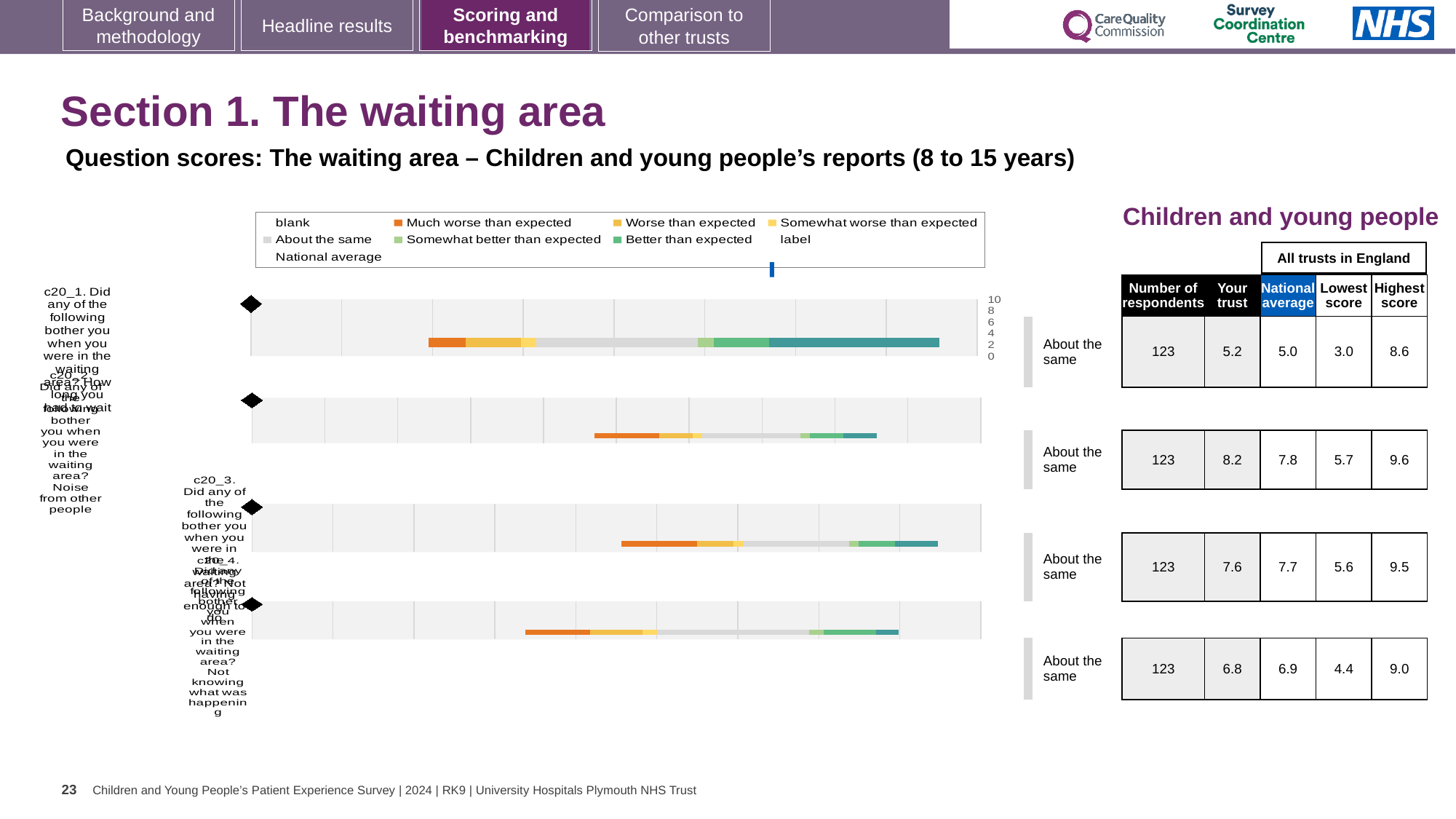
What is the National average score for question c20_2 (Noise from other people)? 7.8 What is the 'Your trust' score for question c20_1 (Did any of the following bother you when you were in the waiting area? How long you had to wait)? 5.2 What kind of chart is used to show the question scores for the waiting area? Bar chart For question c20_2, which is larger: the 'Your trust' score or the National average? Your trust What is the highest tick value shown on the horizontal axis of the first chart? 10 What benchmark label is shown to the right of each of the four charts? About the same How many entries does the legend above the charts list? 9 Which question has the lowest 'Your trust' score? c20_1 Which question has the highest 'Your trust' score? c20_2 How many question charts (c20_1 to c20_4) are shown on the slide? 4 For question c20_1, what is the difference between the Highest score and the Lowest score across all trusts in England? 5.6